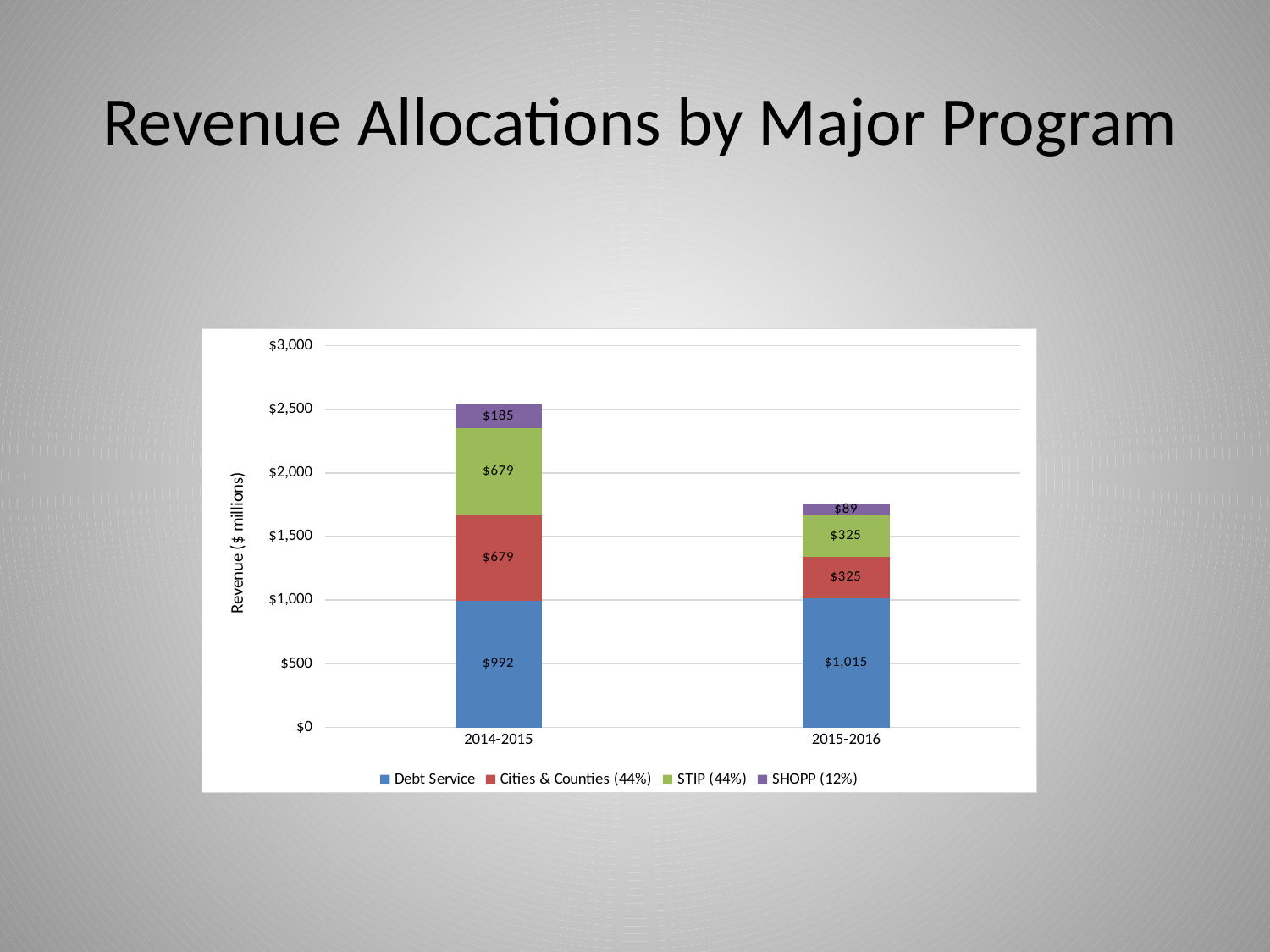
What is the STIP (44%) value for 2015-2016? $325 What is the SHOPP (12%) value for 2014-2015? $185 What is the difference between the Cities & Counties (44%) values for 2014-2015 and 2015-2016? $354 How many series does the legend list? 4 What is the Debt Service value for 2015-2016? $1,015 What is the total of the stacked bar for 2014-2015? $2,535 Is the total of the 2015-2016 stacked bar greater or less than $2,000? less What is the total of the stacked bar for 2015-2016? $1,754 What is the label on the vertical axis? Revenue ($ millions) What is the Debt Service value for 2014-2015? $992 Which year has the larger Debt Service value, 2014-2015 or 2015-2016? 2015-2016 What kind of chart is shown on the slide? Stacked bar chart